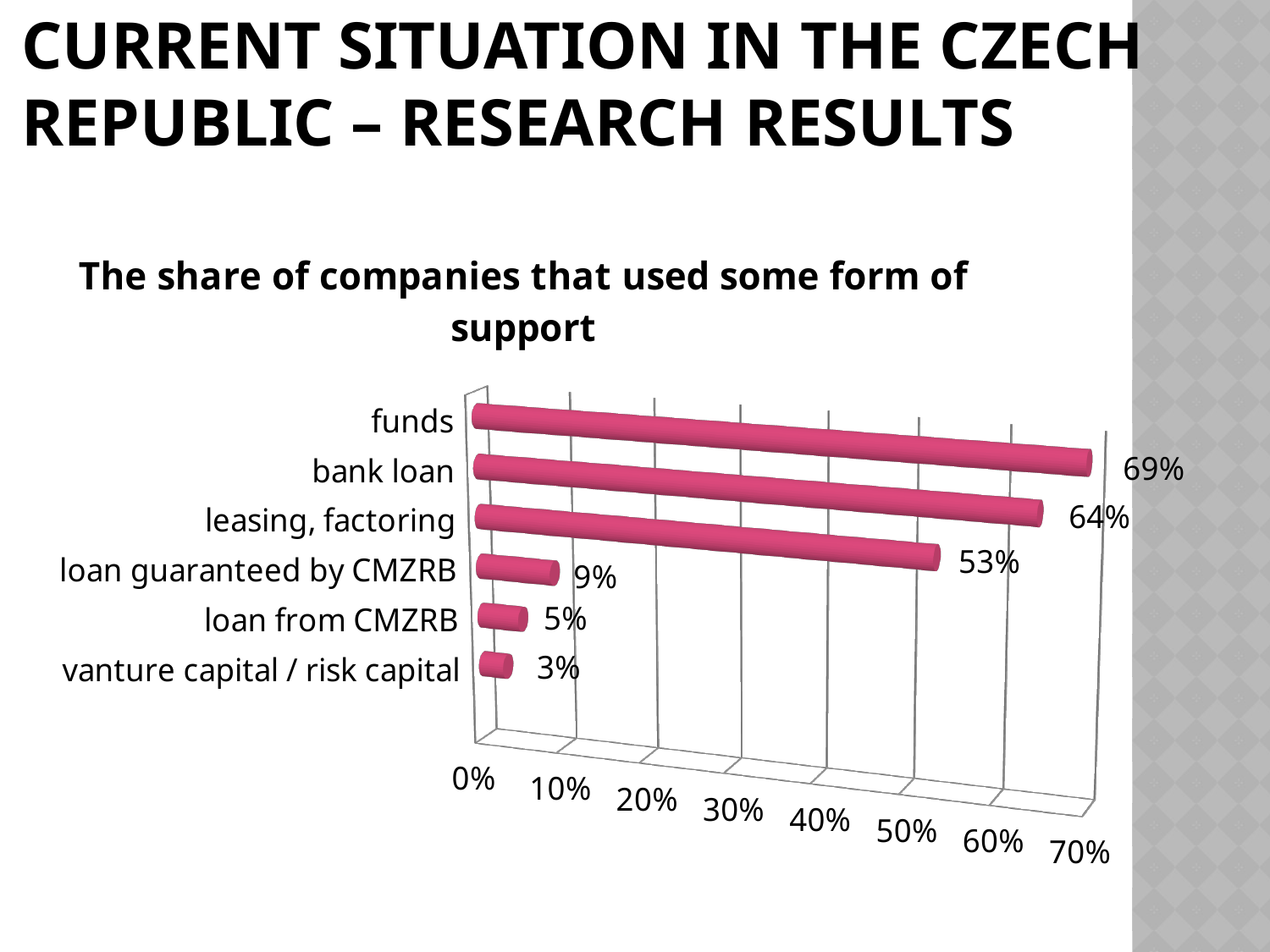
What is the value for funds? 69% How many categories are shown in the chart? 6 Which category has the highest value? funds What is the value for bank loan? 64% Which category has the lowest value? vanture capital / risk capital What is the value for loan guaranteed by CMZRB? 9% What is the value for leasing, factoring? 53% What is the value for vanture capital / risk capital? 3% What is the difference between the values for funds and bank loan? 5% What is the title of the chart? The share of companies that used some form of support Which is larger, the value for loan guaranteed by CMZRB or the value for loan from CMZRB? loan guaranteed by CMZRB What kind of chart is shown on the slide? bar chart